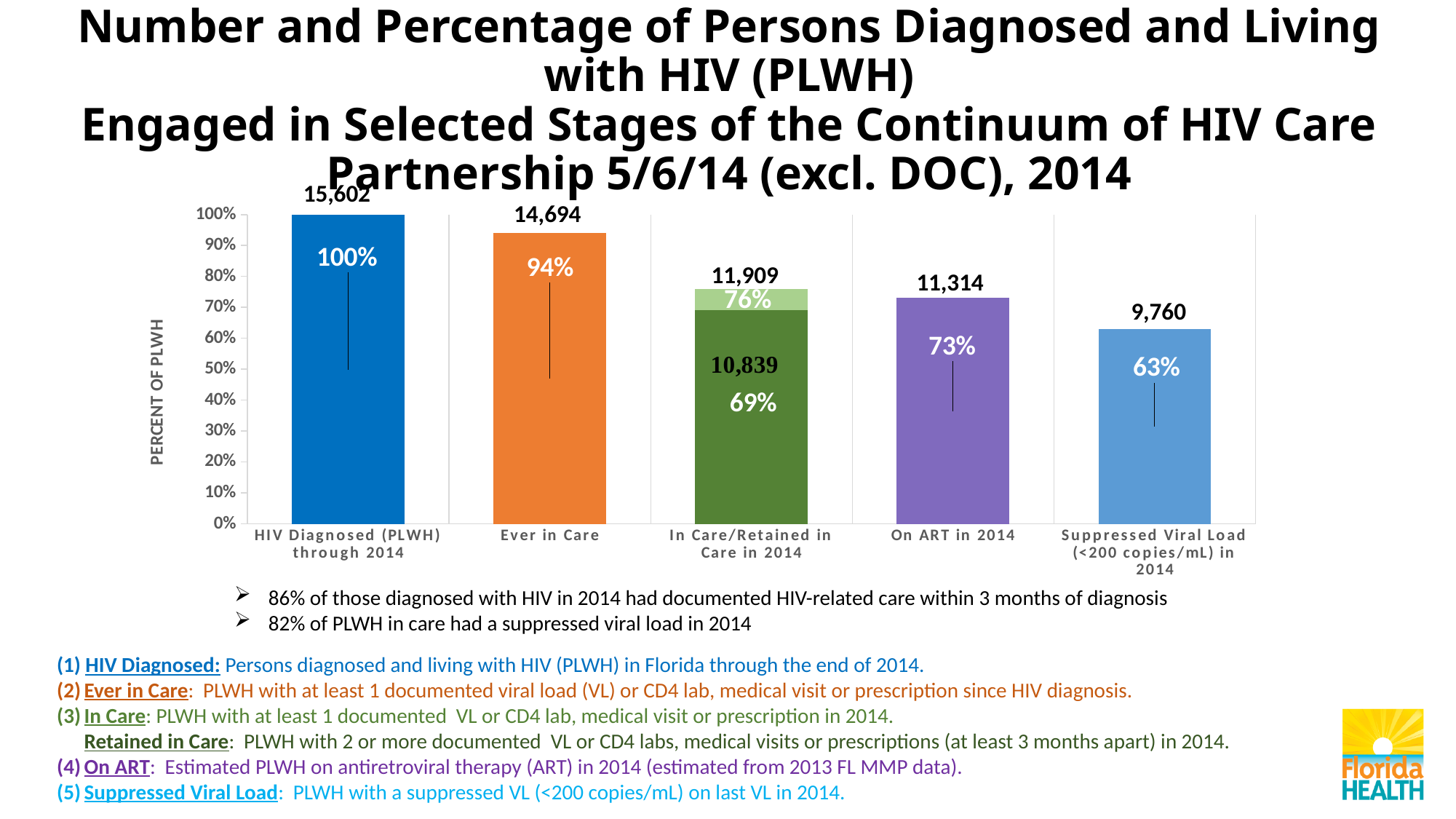
What number is shown for Suppressed Viral Load (<200 copies/mL) in 2014? 9,760 What kind of chart is shown on the slide? Bar chart Which stage of the continuum has the lowest percentage of PLWH? Suppressed Viral Load (<200 copies/mL) in 2014 What number is shown for the Ever in Care bar? 14,694 What is the difference between the In Care number (11,909) and the Retained in Care number (10,839)? 1,070 How many stages of the continuum of HIV care are shown on the x axis? 5 Which stage has the highest number of persons? HIV Diagnosed (PLWH) through 2014 What percentage of PLWH were on ART in 2014? 73% How many more persons were HIV Diagnosed (PLWH) through 2014 than Ever in Care? 908 Which is larger: the number On ART in 2014 or the number with Suppressed Viral Load in 2014? On ART in 2014 What percentage is shown for Retained in Care in 2014 (the darker green portion)? 69%